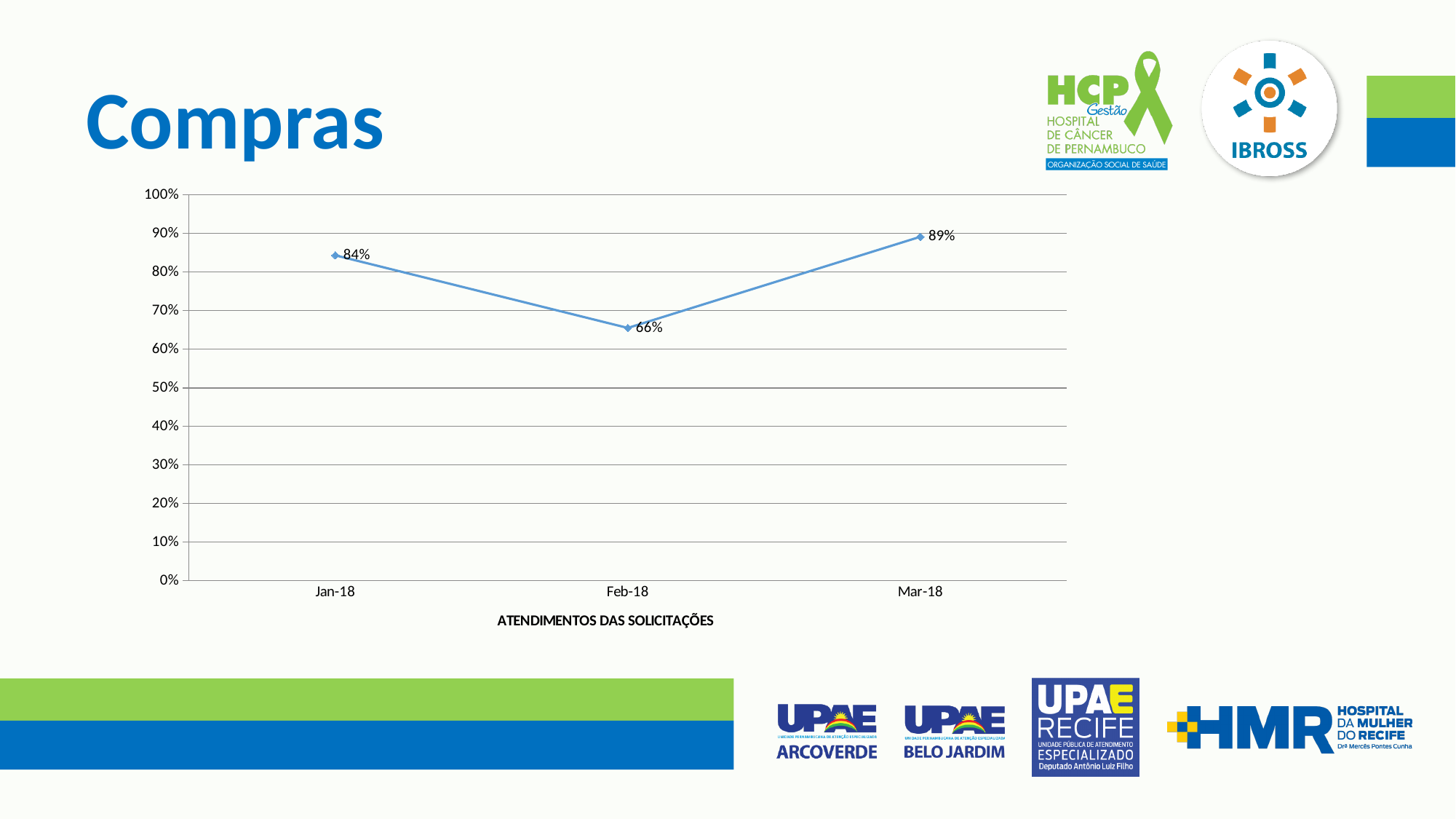
What is the value for Feb-18? 66% What kind of chart is shown on the slide? line chart Which month has the highest value? Mar-18 Is the value for Feb-18 greater or less than 70%? less What is the difference between the values for Mar-18 and Feb-18? 23% What is the value for Jan-18? 84% What is the label shown below the x axis of the chart? ATENDIMENTOS DAS SOLICITAÇÕES How many data points are plotted on the chart? 3 What is the difference between the values for Jan-18 and Feb-18? 18% Which is larger, the value for Jan-18 or the value for Mar-18? Mar-18 Which month has the lowest value? Feb-18 What is the value for Mar-18? 89%